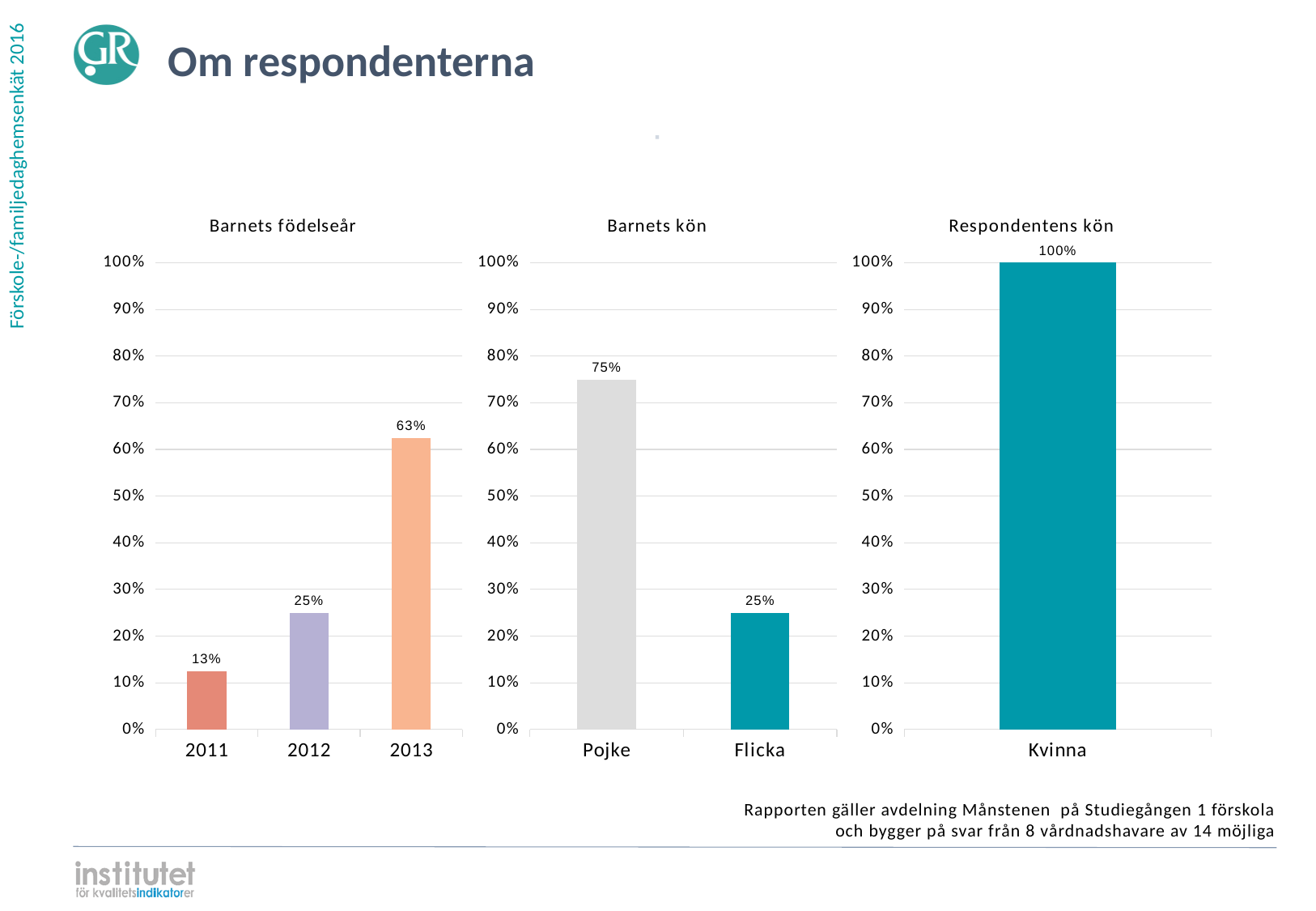
In the 'Barnets födelseår' chart, which year has the highest value? 2013 In the 'Barnets kön' chart, what is the value for Pojke? 75% In the 'Barnets födelseår' chart, what is the value for 2011? 13% What kind of chart is the 'Respondentens kön' chart? bar chart In the 'Barnets födelseår' chart, what is the difference between the values for 2013 and 2012? 38% In the 'Respondentens kön' chart, what is the value for Kvinna? 100% In the 'Barnets födelseår' chart, how many categories are shown on the x axis? 3 In the 'Barnets kön' chart, what is the difference between Pojke and Flicka? 50% In the 'Barnets kön' chart, which is larger, Pojke or Flicka? Pojke In the 'Barnets födelseår' chart, which year has the lowest value? 2011 In the 'Barnets födelseår' chart, do the values rise or fall from 2011 to 2013? rise In the 'Barnets födelseår' chart, what is the value for 2013? 63%